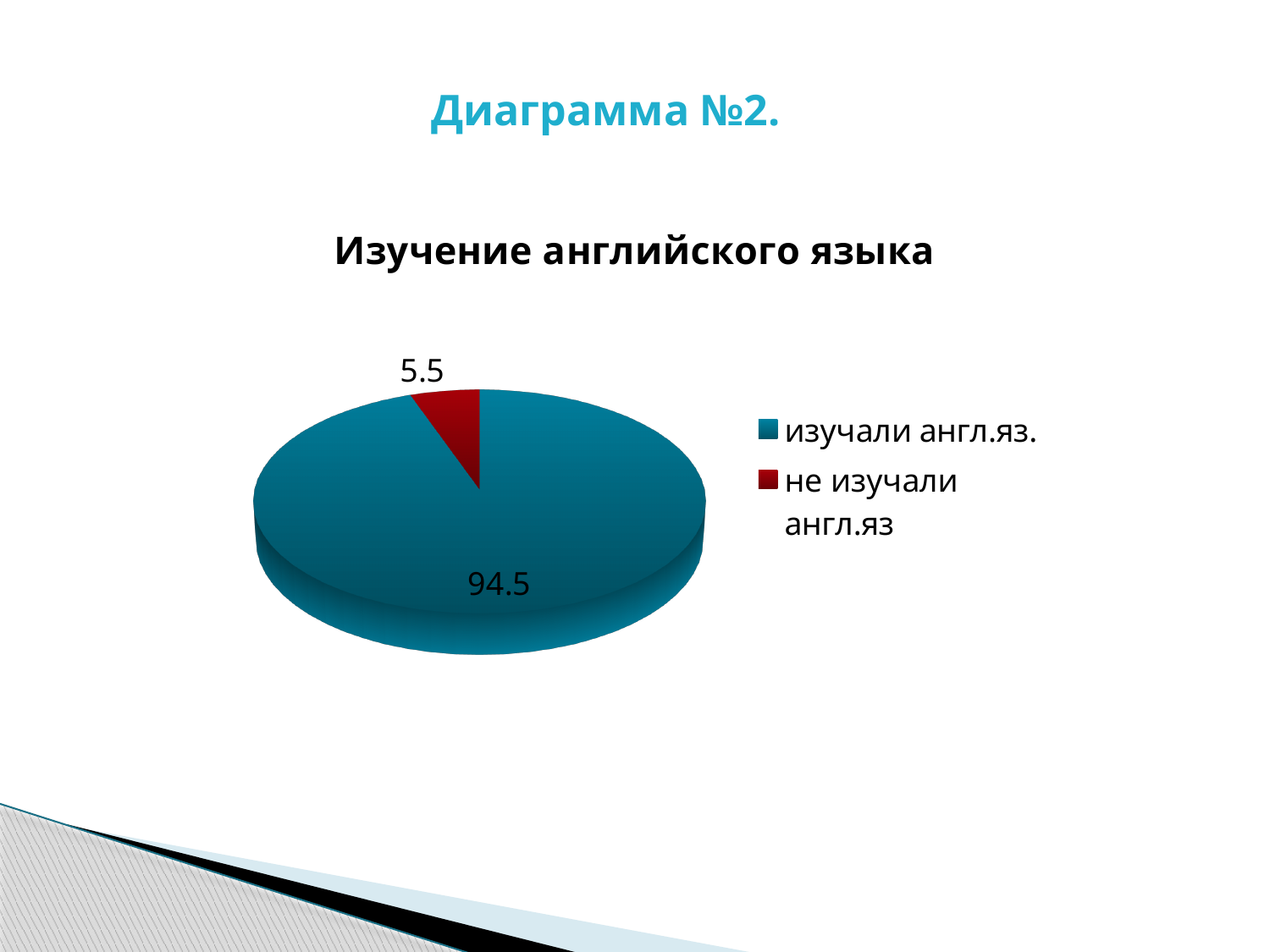
What colour is the slice for "не изучали англ.яз"? dark red What is the difference between the values for "изучали англ.яз." and "не изучали англ.яз"? 89 How many slices does the pie chart have? 2 Which is larger: "изучали англ.яз." or "не изучали англ.яз"? изучали англ.яз. What type of chart is shown on the slide? pie chart What is the title of the chart? Изучение английского языка What is the total of the two values shown on the pie chart? 100 Which category has the smallest slice? не изучали англ.яз What is the value for "изучали англ.яз."? 94.5 What is the value for "не изучали англ.яз"? 5.5 How many entries does the legend list? 2 Which category has the largest slice? изучали англ.яз.